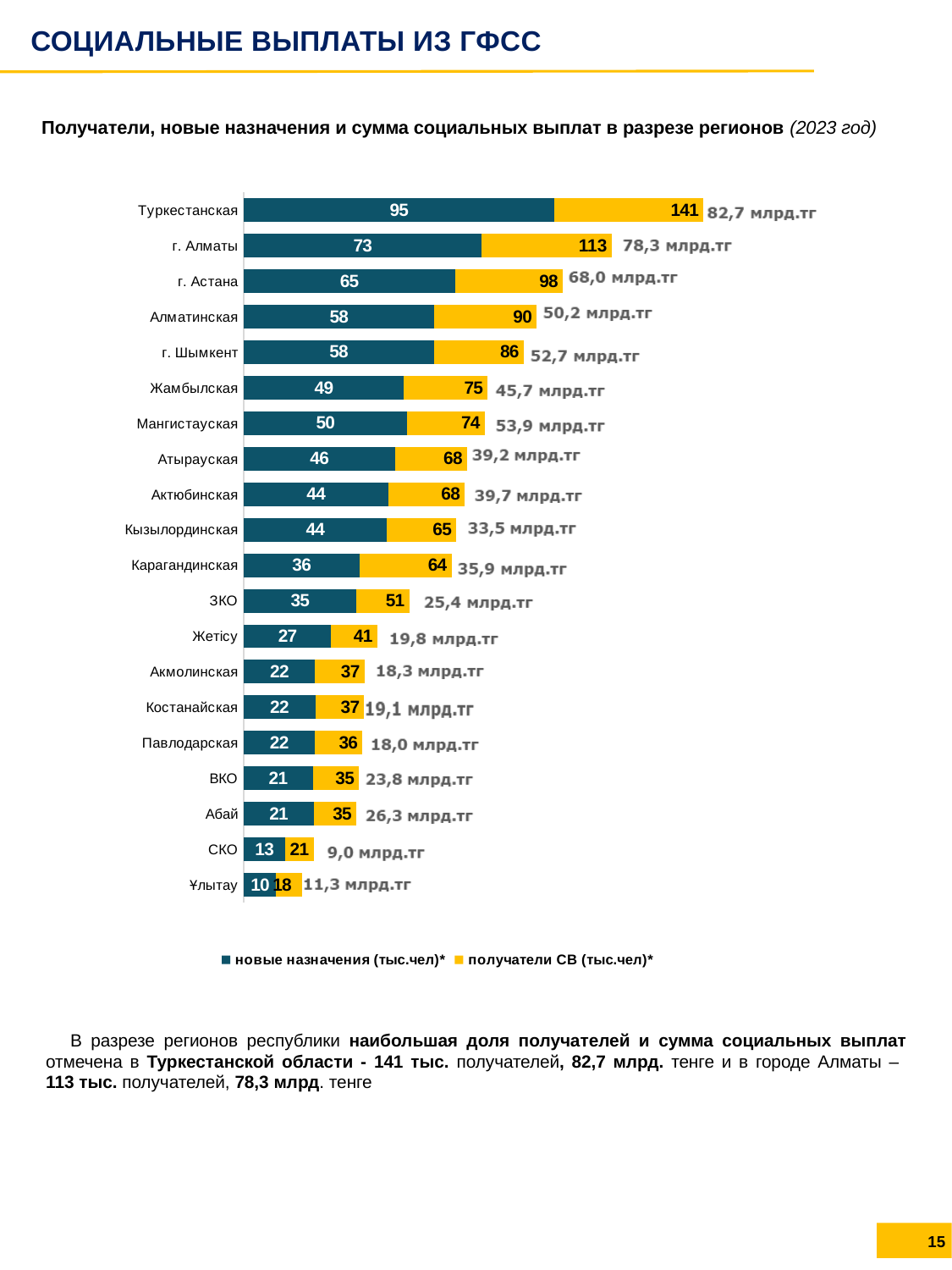
Which region has the highest value of получатели СВ (тыс.чел)? Туркестанская What is the value of получатели СВ (тыс.чел) for г. Алматы? 113 Which region has a larger value of новые назначения (тыс.чел): Жамбылская or Мангистауская? Мангистауская What sum in млрд.тг is shown next to the bar for г. Астана? 68,0 млрд.тг Which region has the lowest value of новые назначения (тыс.чел)? Ұлытау What is the total of the stacked bar for СКО? 34 What is the difference between the получатели СВ values for Туркестанская and г. Алматы? 28 What is the value of новые назначения (тыс.чел) for Туркестанская? 95 How many regions are shown in the chart? 20 Which colour represents получатели СВ (тыс.чел) in the chart? Yellow How many series does the legend list? 2 What kind of chart is shown on the slide? Stacked horizontal bar chart